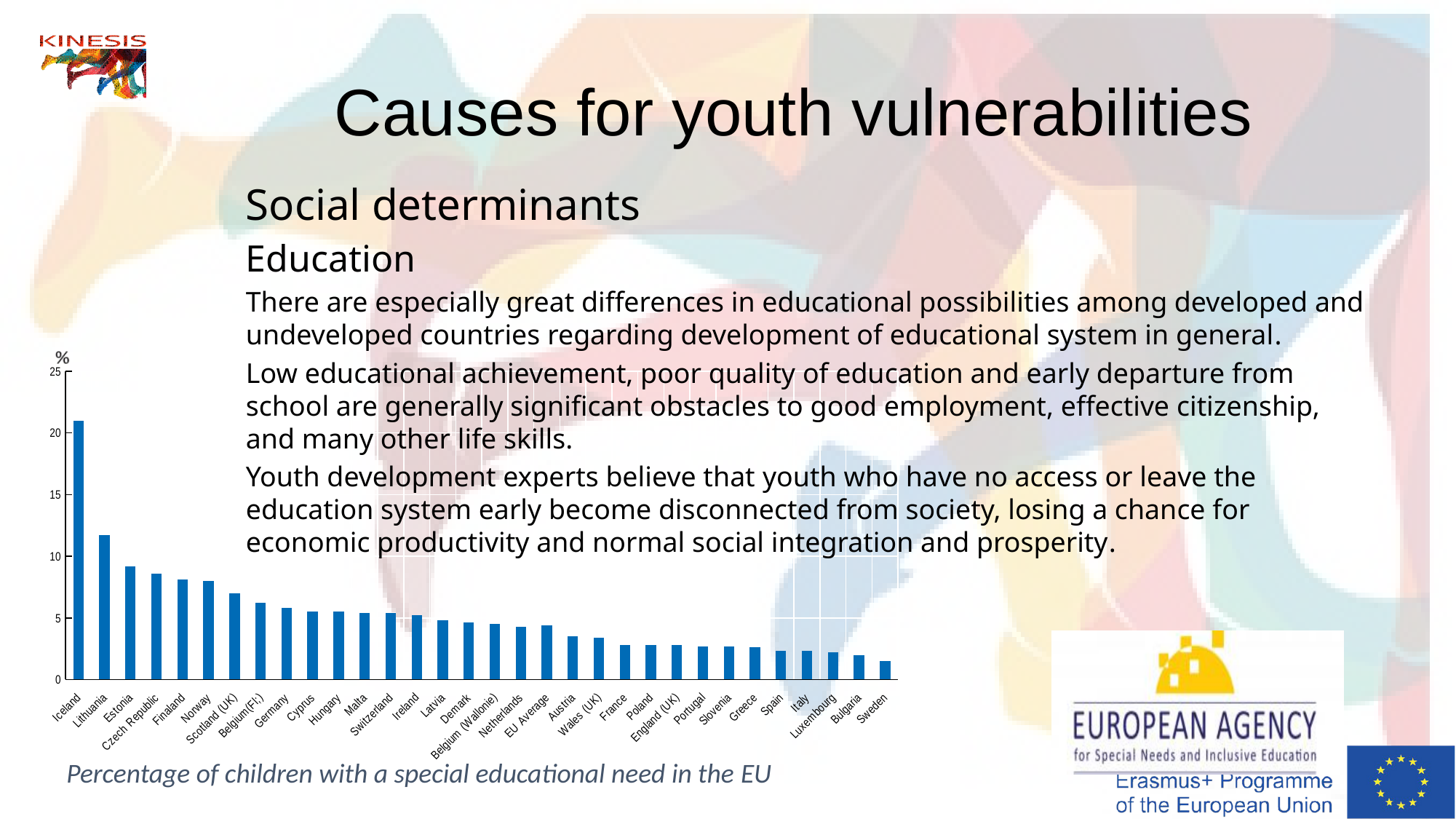
What does the chart show, according to the caption below it? Percentage of children with a special educational need in the EU Is the value for Estonia greater or less than 10? less Which has a higher value, Iceland or Lithuania? Iceland Do the bar values rise or fall from left to right along the x axis? fall Is the value for Lithuania greater or less than 10? greater What kind of chart is shown on the slide? bar chart Which country has the lowest percentage of children with a special educational need? Sweden Is the value for Iceland greater or less than 20? greater Which country has the highest percentage of children with a special educational need? Iceland Which has a higher value, Czech Republic or Greece? Czech Republic